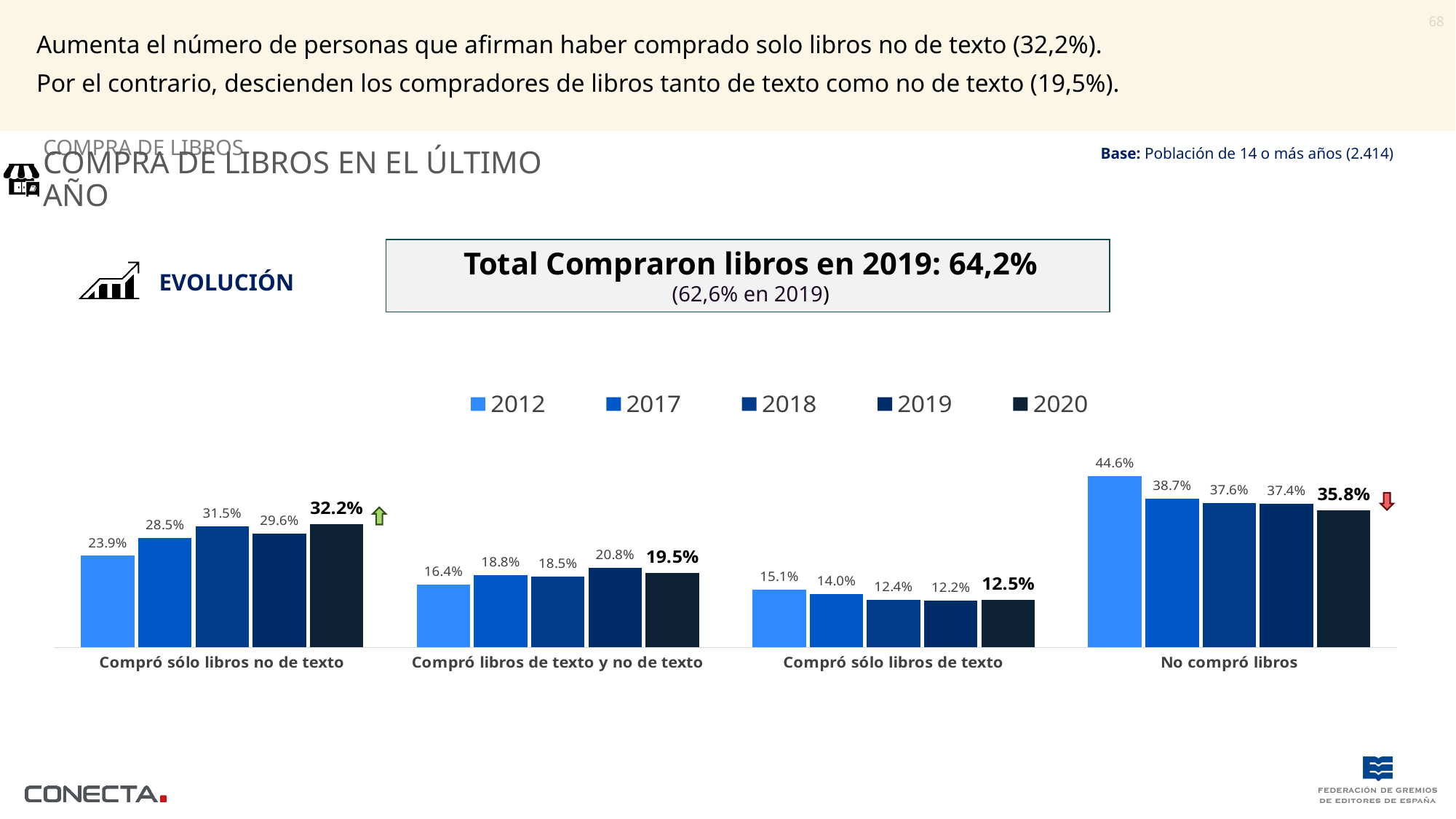
Which year is shown in the lightest blue in the legend? 2012 What is the value for 2012 in the 'No compró libros' category? 44.6% Which year has the lowest value in the 'Compró sólo libros de texto' category? 2019 What is the difference between the 2020 and 2019 values in the 'Compró sólo libros no de texto' category? 2.6% What is the value for 2018 in the 'Compró sólo libros de texto' category? 12.4% How many series does the legend list? 5 How many categories are shown on the x axis? 4 Which is larger in the 'Compró libros de texto y no de texto' category: the 2017 value or the 2018 value? 2017 What kind of chart is shown on the slide? Bar chart Which year has the highest value in the 'No compró libros' category? 2012 What is the value for 2020 in the 'Compró sólo libros no de texto' category? 32.2% What is the value for 2019 in the 'Compró libros de texto y no de texto' category? 20.8%